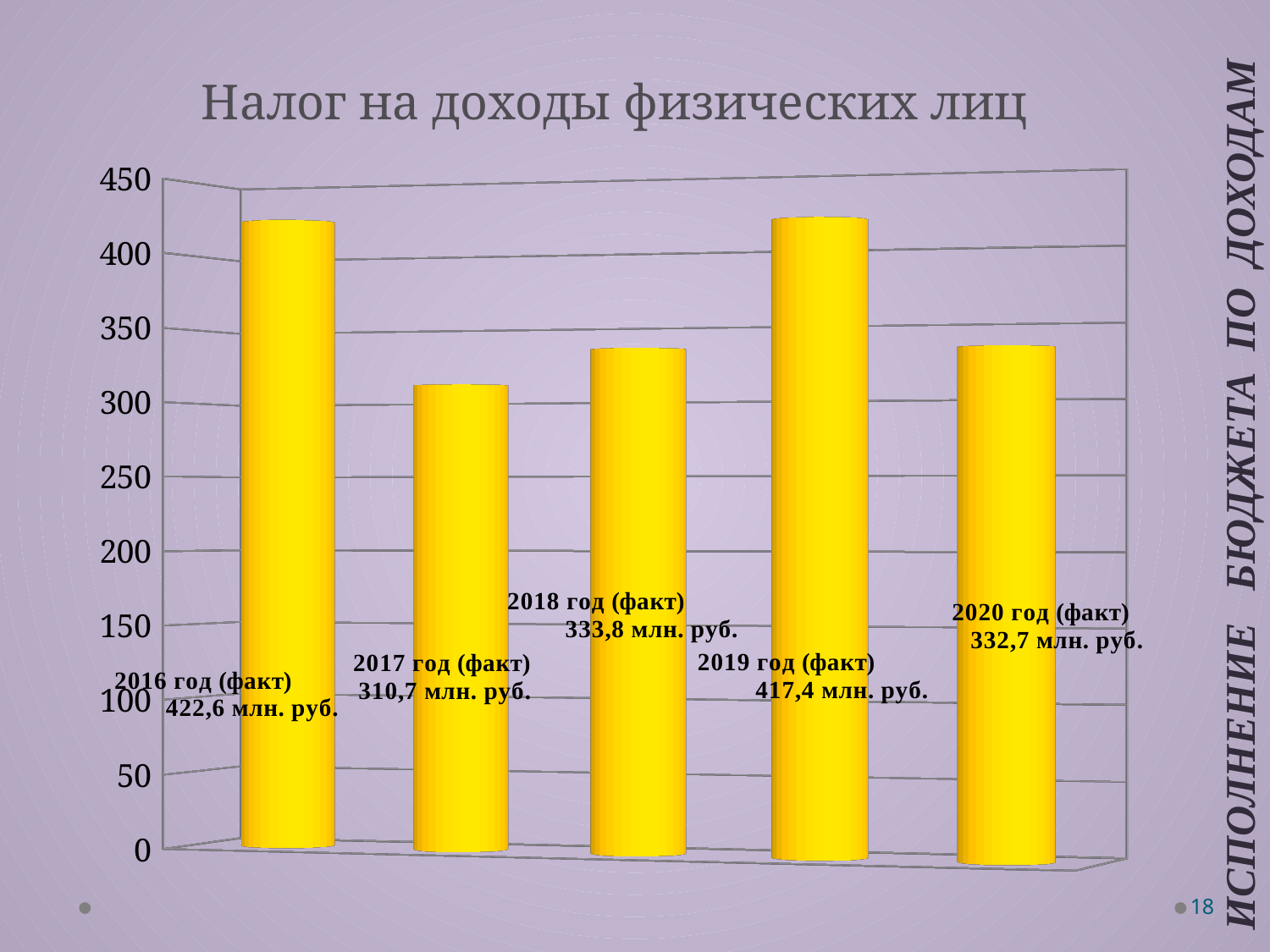
Which year has the lowest value? 2017 год (факт) What is the value for 2019 год (факт)? 417,4 млн. руб. What is the value for 2020 год (факт)? 332,7 млн. руб. What is the difference between the values for 2019 год (факт) and 2020 год (факт)? 84,7 млн. руб. What is the difference between the values for 2016 год (факт) and 2017 год (факт)? 111,9 млн. руб. Is the value for 2018 год (факт) greater or less than 350? less Which is larger, the value for 2016 год (факт) or 2019 год (факт)? 2016 год (факт) What is the title of the chart? Налог на доходы физических лиц Which year has the highest value? 2016 год (факт) What is the value for 2017 год (факт)? 310,7 млн. руб. How many bars are shown in the chart? 5 What is the value for 2016 год (факт)? 422,6 млн. руб.